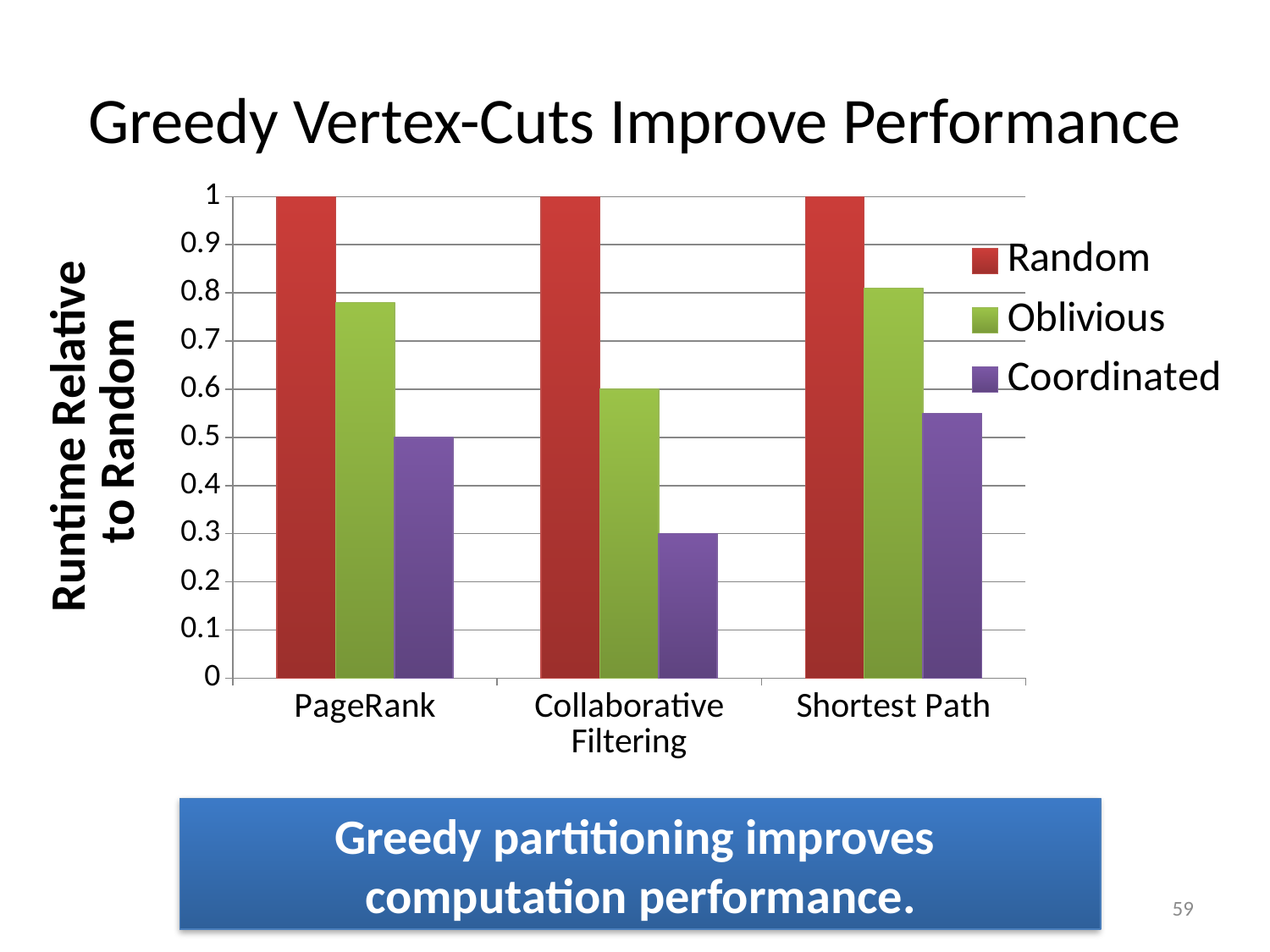
Is the Oblivious value for PageRank greater or less than 0.7? greater What is the Random value for PageRank? 1 Is the Coordinated value for Shortest Path greater or less than 0.4? greater What is the Coordinated value for PageRank? 0.5 How many series does the legend list? 3 What kind of chart is shown on the slide? bar chart Which is larger, the Oblivious value for PageRank or the Oblivious value for Collaborative Filtering? PageRank What is the difference between the Random and Coordinated values for Collaborative Filtering? 0.7 What is the Oblivious value for Collaborative Filtering? 0.6 How many categories are shown on the x axis? 3 Which category has the lowest Coordinated value? Collaborative Filtering What is the Coordinated value for Collaborative Filtering? 0.3